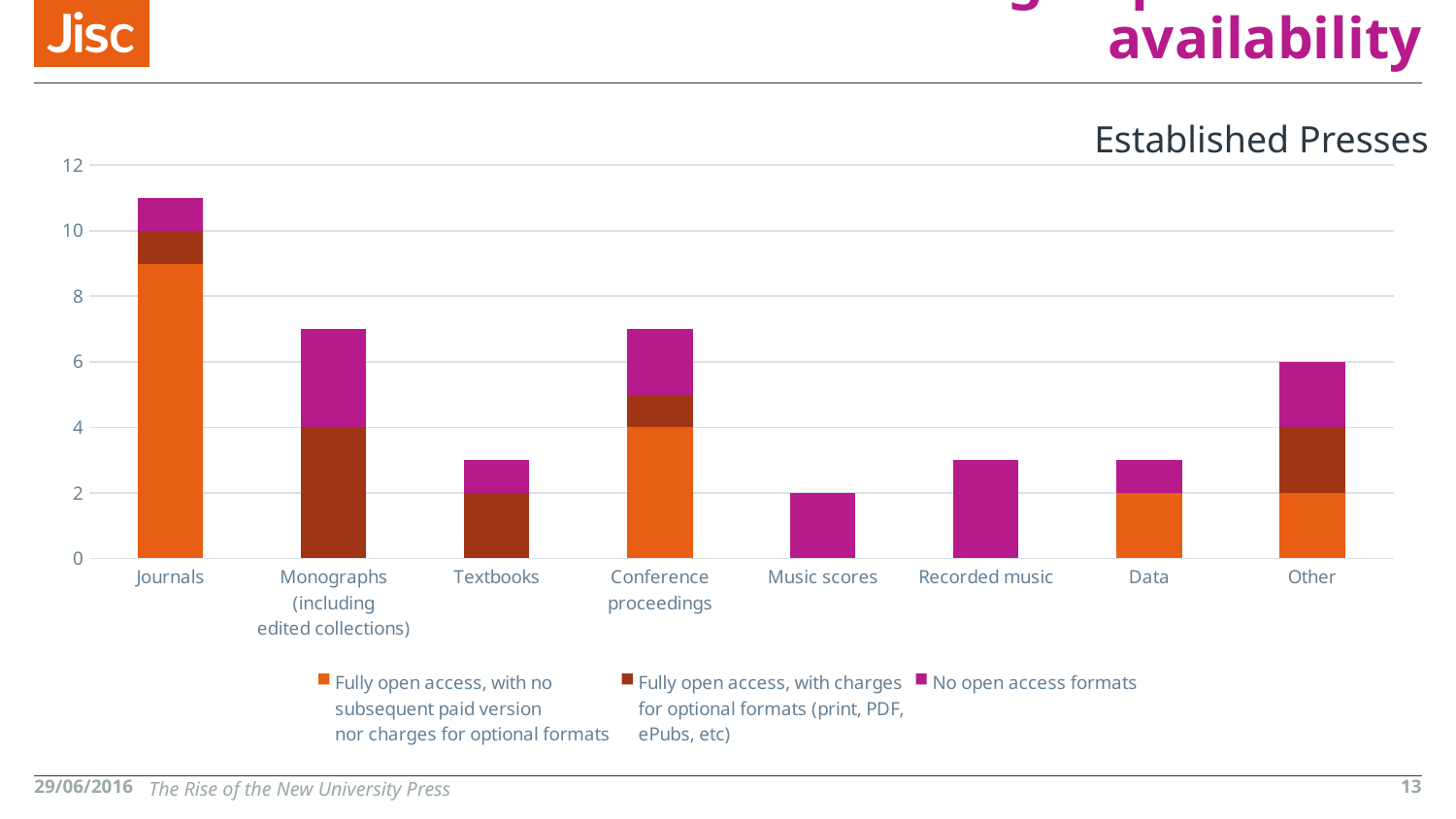
What is the subtitle shown above the chart? Established Presses What is the total height of the stacked bar for Other? 6 Is the total for Recorded music greater or less than 4? less Is the total for Journals greater or less than 10? greater What is the value of the 'Fully open access, with charges for optional formats' segment for Monographs (including edited collections)? 4 How many series does the chart's legend list? 3 Which category has the shortest stacked bar? Music scores Which category has the tallest stacked bar? Journals Which stacked bar is taller, Journals or Other? Journals How many categories are shown on the x axis of the chart? 8 What is the total height of the stacked bar for Music scores? 2 What kind of chart is shown on the slide? Stacked bar chart